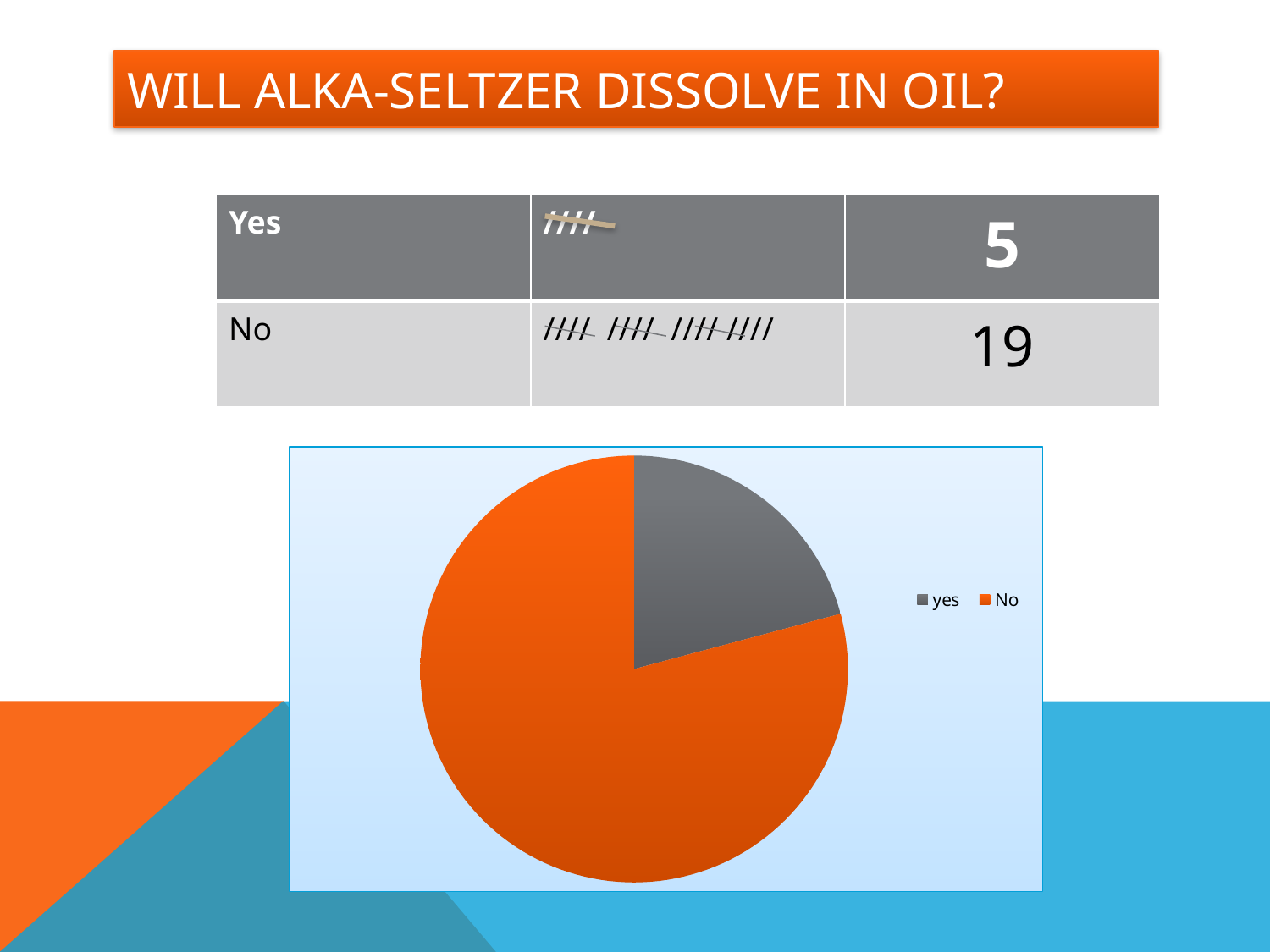
What are the two legend entries of the pie chart? yes, No Does the 'yes' slice take up more or less than half of the pie chart? less In the pie chart, which is larger, the 'yes' slice or the 'No' slice? No Which slice of the pie chart is the smallest? yes How many slices does the pie chart have? 2 Does the 'No' slice take up more or less than half of the pie chart? more What kind of chart is shown on the slide? pie chart How many entries does the pie chart's legend list? 2 What colour is the 'No' slice in the pie chart? orange Which slice of the pie chart is the largest? No